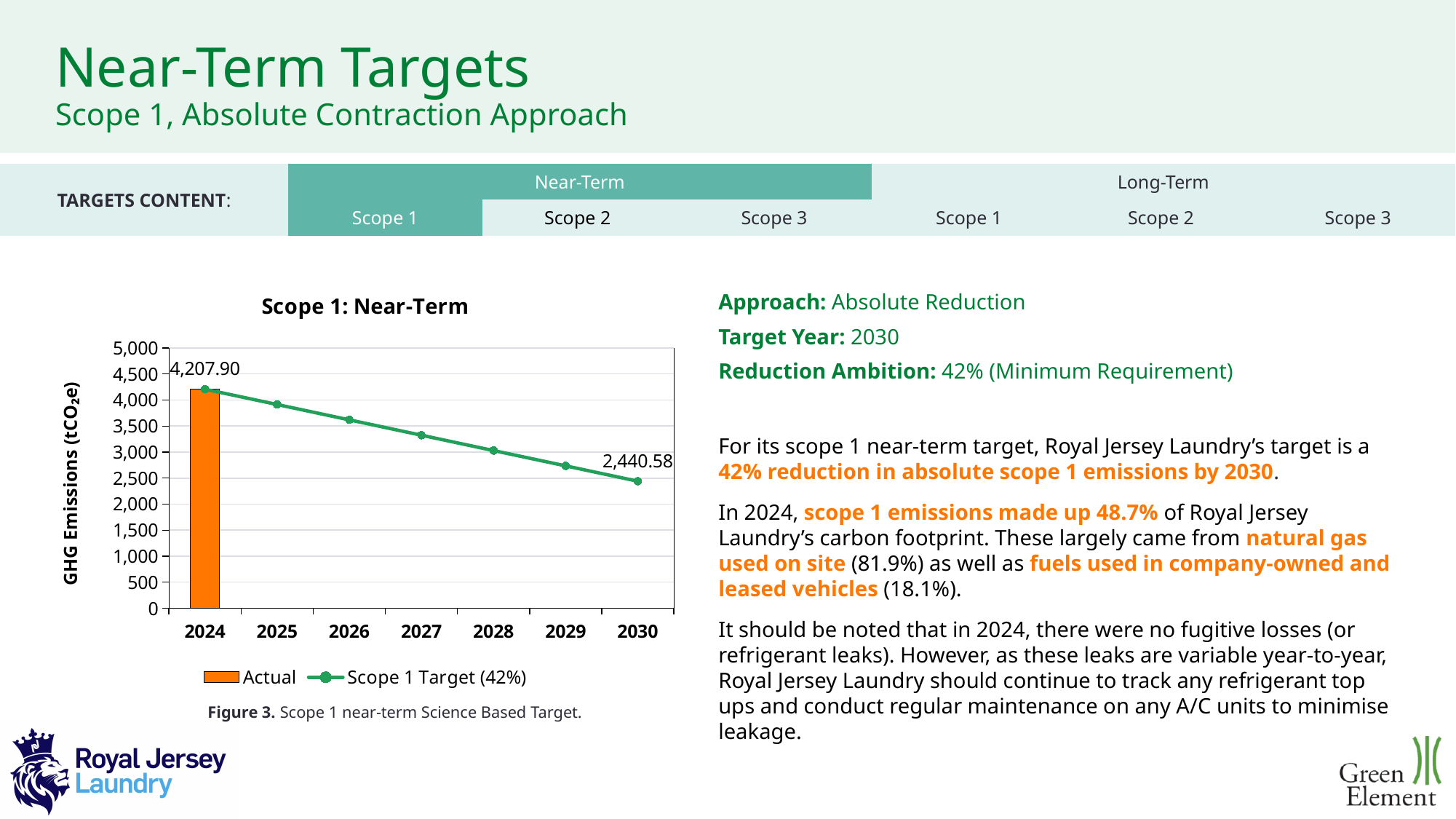
What is the value of the Actual bar for 2024 in the Scope 1: Near-Term chart? 4,207.90 What is the difference between the 2024 value (4,207.90) and the 2030 target value (2,440.58)? 1,767.32 Which year has the highest Scope 1 Target value? 2024 Is the Scope 1 Target value for 2026 greater or less than 3,500? greater Is the Scope 1 Target value for 2029 greater or less than 3,000? less What is the Scope 1 Target value shown for 2030? 2,440.58 How many series does the chart legend list? 2 How many years are shown on the x axis of the chart? 7 What is the label on the y axis of the chart? GHG Emissions (tCO₂e) What kind of chart is shown on the slide? Combination bar and line chart Is the Scope 1 Target value for 2027 greater or less than 3,500? less Does the Scope 1 Target line rise or fall from 2024 to 2030? Fall